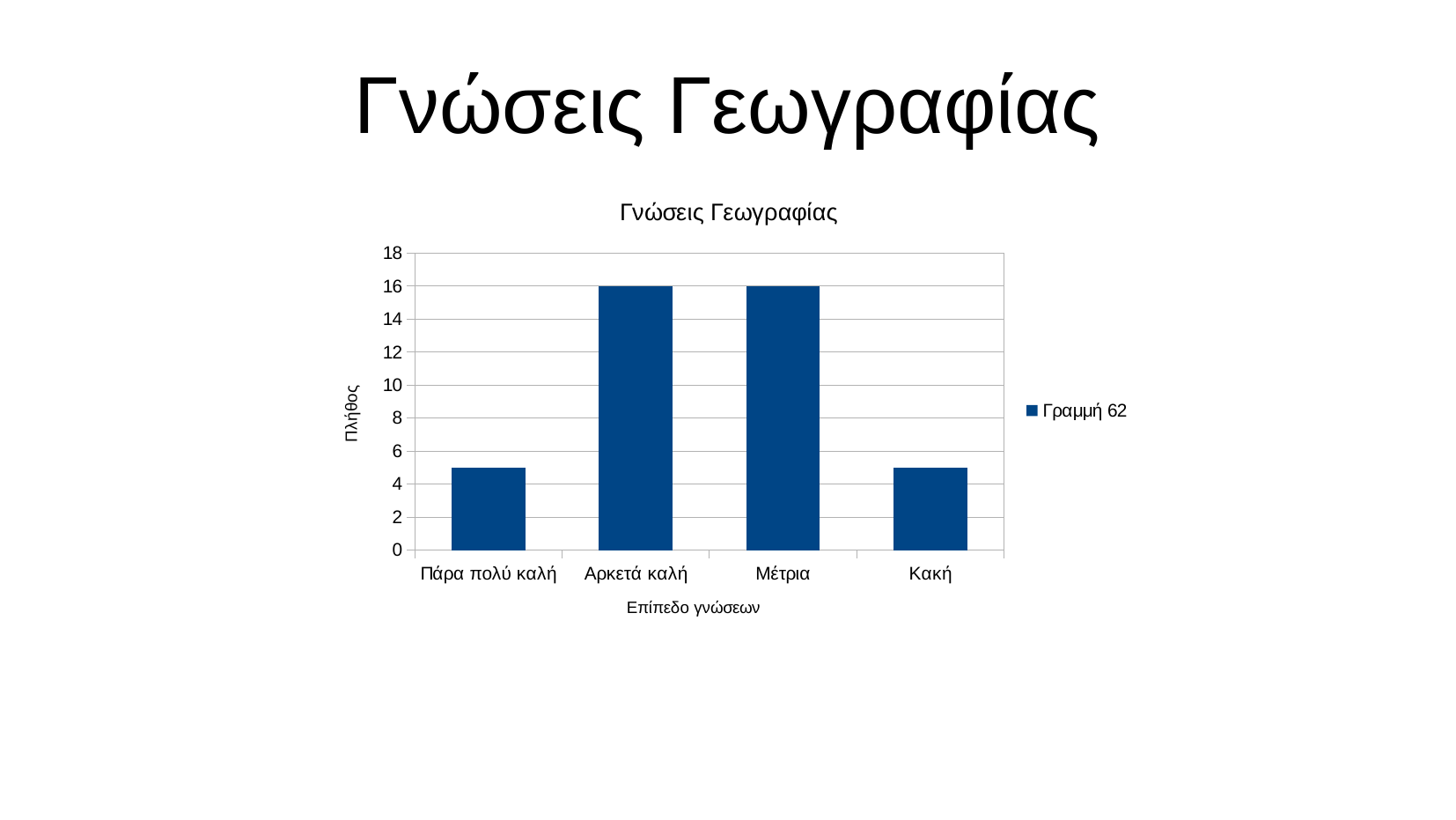
How many series does the legend list? 1 Which is larger, the value for Πάρα πολύ καλή or the value for Μέτρια? Μέτρια Is the value for Κακή greater or less than 4? greater What is the name of the series shown in the legend? Γραμμή 62 What is the value for Αρκετά καλή? 16 Is the value for Πάρα πολύ καλή greater or less than 6? less Is the value for Αρκετά καλή greater or less than 10? greater What type of chart is shown on the slide? bar chart What is the value for Μέτρια? 16 Which is larger, the value for Αρκετά καλή or the value for Κακή? Αρκετά καλή What is the title of the x axis? Επίπεδο γνώσεων How many categories are shown on the x axis of the chart? 4